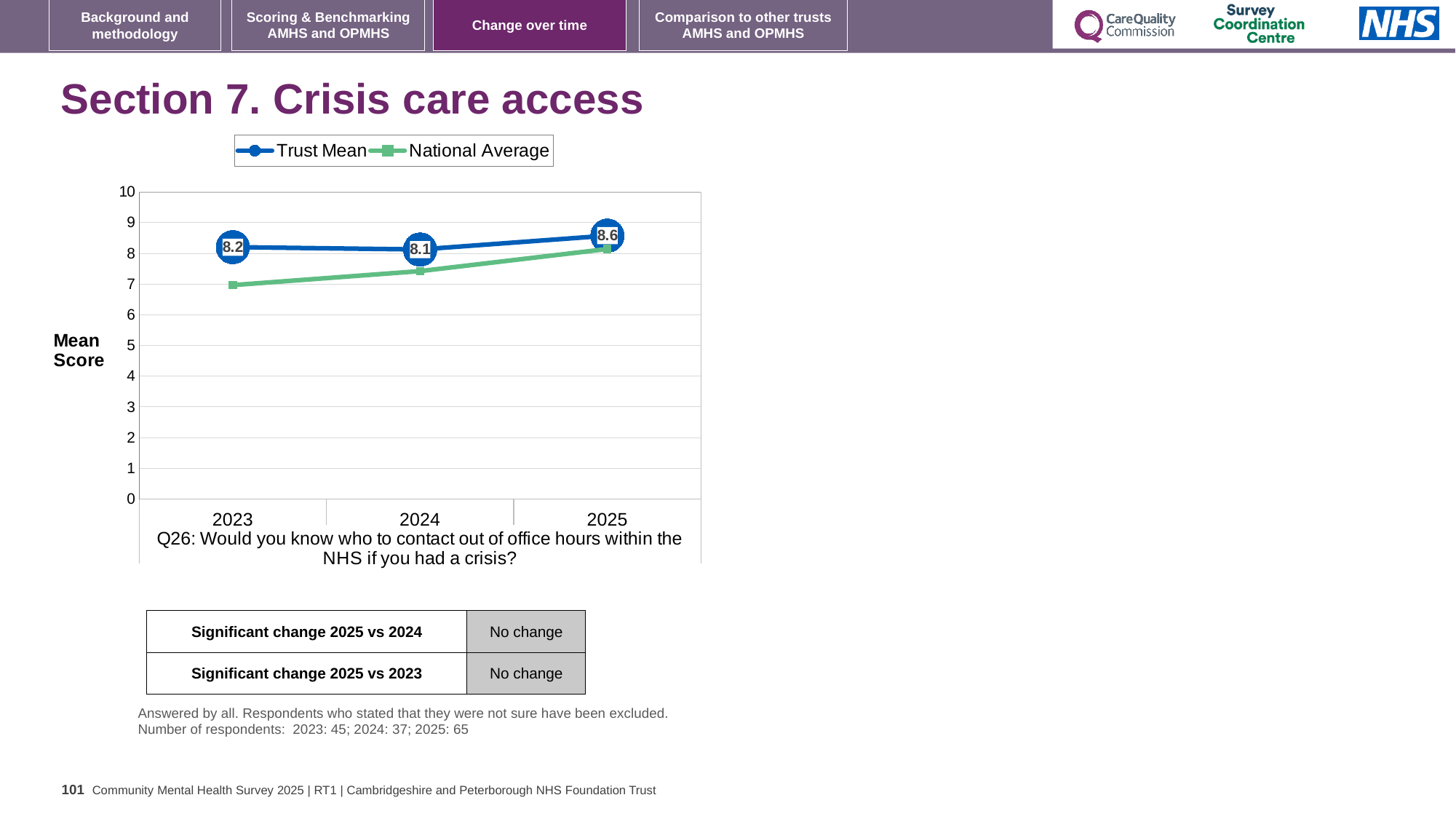
What is the difference between the Trust Mean in 2025 and in 2024? 0.5 What kind of chart is shown on the slide? line chart How many years are plotted on the x axis? 3 In which year is the Trust Mean highest? 2025 How many series does the legend list? 2 What is the Trust Mean value for 2025? 8.6 Which is larger in 2023, the Trust Mean or the National Average? Trust Mean Is the National Average value for 2023 greater or less than 8? less What is the Trust Mean value for 2024? 8.1 Does the National Average rise or fall from 2023 to 2025? rise In which year is the Trust Mean lowest? 2024 What is the Trust Mean value for 2023? 8.2